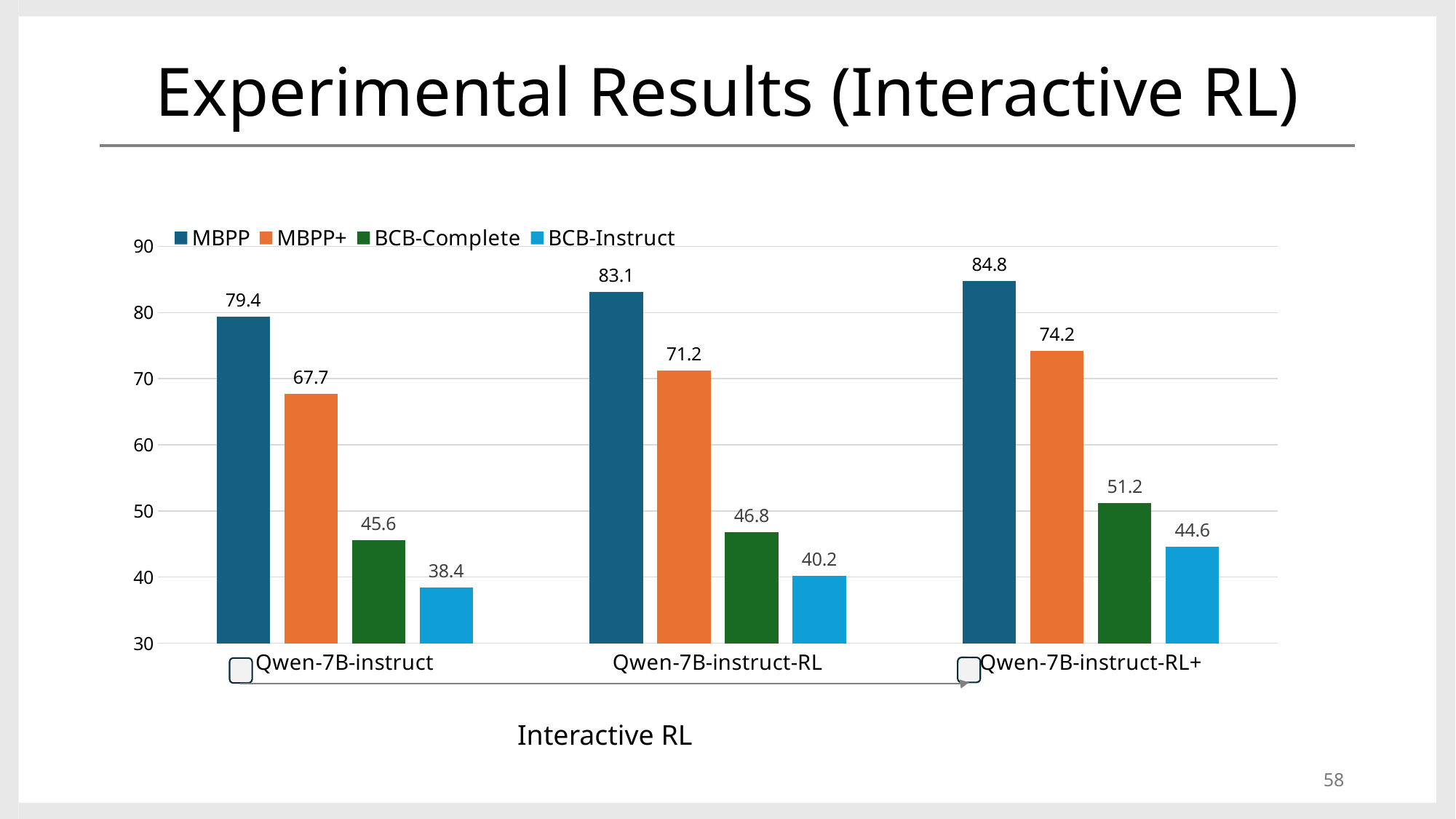
How many series does the legend list? 4 What is the BCB-Instruct value for Qwen-7B-instruct? 38.4 What is the MBPP value for Qwen-7B-instruct-RL? 83.1 Which colour represents the BCB-Instruct series in the legend? Light blue Which model has the highest BCB-Complete value? Qwen-7B-instruct-RL+ What kind of chart is shown on the slide? Bar chart Which model has the lowest MBPP value? Qwen-7B-instruct How many models are shown on the x axis? 3 Which is larger: the BCB-Instruct value for Qwen-7B-instruct-RL or the BCB-Complete value for Qwen-7B-instruct? BCB-Complete value for Qwen-7B-instruct What is the difference between the MBPP values for Qwen-7B-instruct-RL+ and Qwen-7B-instruct? 5.4 Do the MBPP+ values rise or fall from Qwen-7B-instruct to Qwen-7B-instruct-RL+? Rise What is the MBPP+ value for Qwen-7B-instruct-RL+? 74.2